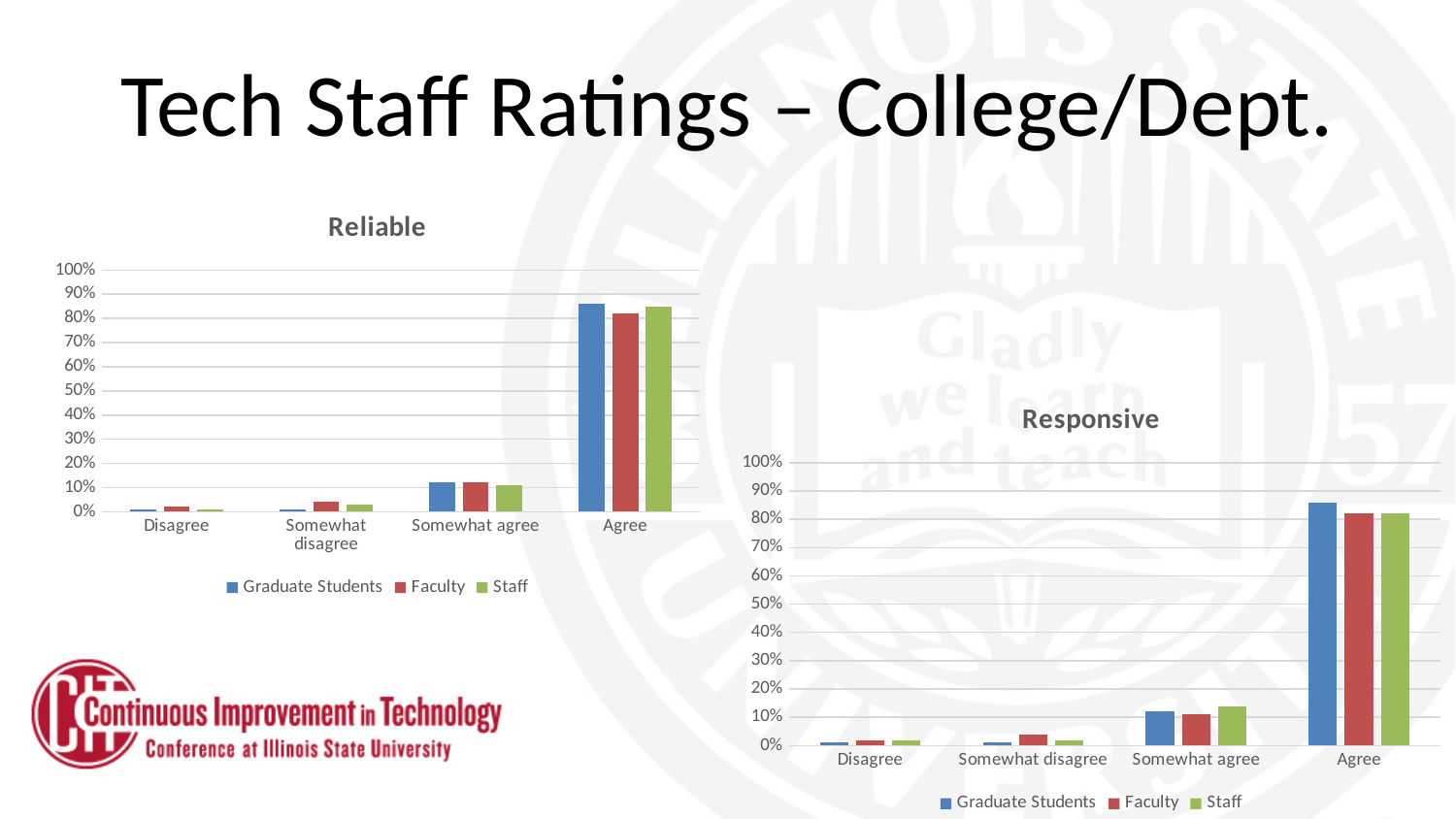
What kind of chart is the 'Reliable' chart? bar chart What are the legend entries of the 'Responsive' chart? Graduate Students, Faculty, Staff In the 'Responsive' chart, which is larger for Agree: Graduate Students or Faculty? Graduate Students How many categories are shown on the x axis of the 'Reliable' chart? 4 In the 'Responsive' chart, which category has the highest value for Staff? Agree In the 'Reliable' chart, is the Graduate Students value for Agree greater or less than 80%? greater In the 'Responsive' chart, is the Faculty value for Agree greater or less than 90%? less How many series does the legend of the 'Reliable' chart list? 3 In the 'Responsive' chart, which is larger for Faculty: Disagree or Somewhat disagree? Somewhat disagree In the 'Responsive' chart, is the Staff value for Somewhat agree greater or less than 10%? greater In the 'Reliable' chart, which category has the highest value for Graduate Students? Agree